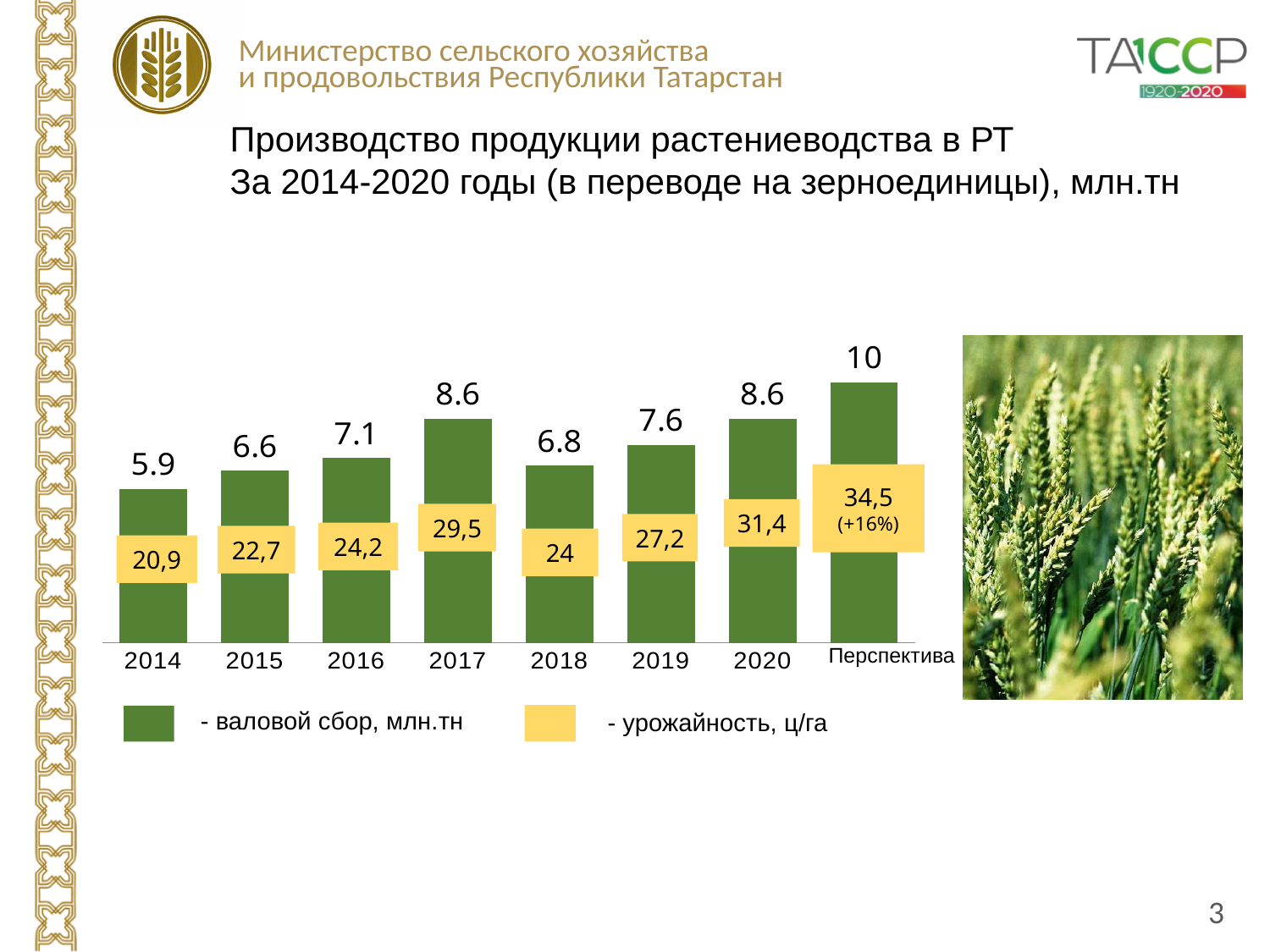
What yield (урожайность, ц/га) is shown for 2020? 31,4 Do the gross harvest values rise or fall from 2014 to 2017? rise How many categories are shown along the x axis? 8 What is the gross harvest (валовой сбор) value shown for 2018? 6.8 Which year has the lowest gross harvest value? 2014 How many series does the legend list? 2 What is the difference between the gross harvest values for 2020 and 2014? 2.7 Which category has the highest gross harvest value? Перспектива What percentage increase is noted next to the yield value for Перспектива? +16% What kind of chart is shown on the slide? bar chart Which year has the larger gross harvest value, 2017 or 2019? 2017 What yield (урожайность, ц/га) is shown for 2014? 20,9